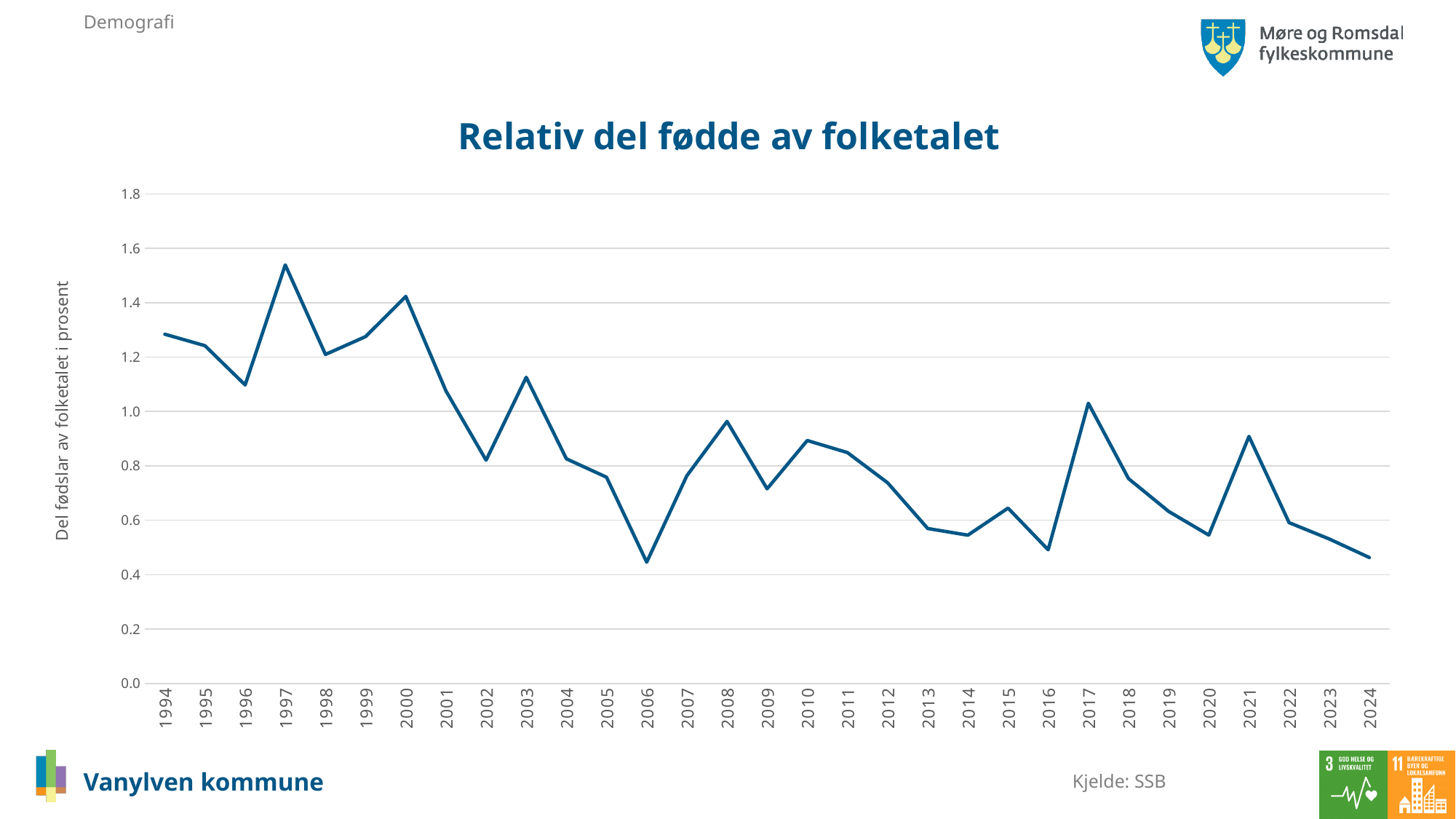
Is the value for 2016 greater or less than 0.6? less Is the value for 1997 greater or less than 1.4? greater Which year has the larger value, 1994 or 2024? 1994 Overall, do the values rise or fall from 1994 to 2024? fall Which year has the larger value, 1997 or 2000? 1997 Which year has the highest value in the chart? 1997 What is the label on the vertical axis of the chart? Del fødslar av folketalet i prosent What is the title of the chart? Relativ del fødde av folketalet What kind of chart is shown on the slide? line chart Is the value for 2003 greater or less than 1.0? greater How many years are plotted along the x axis of the chart? 31